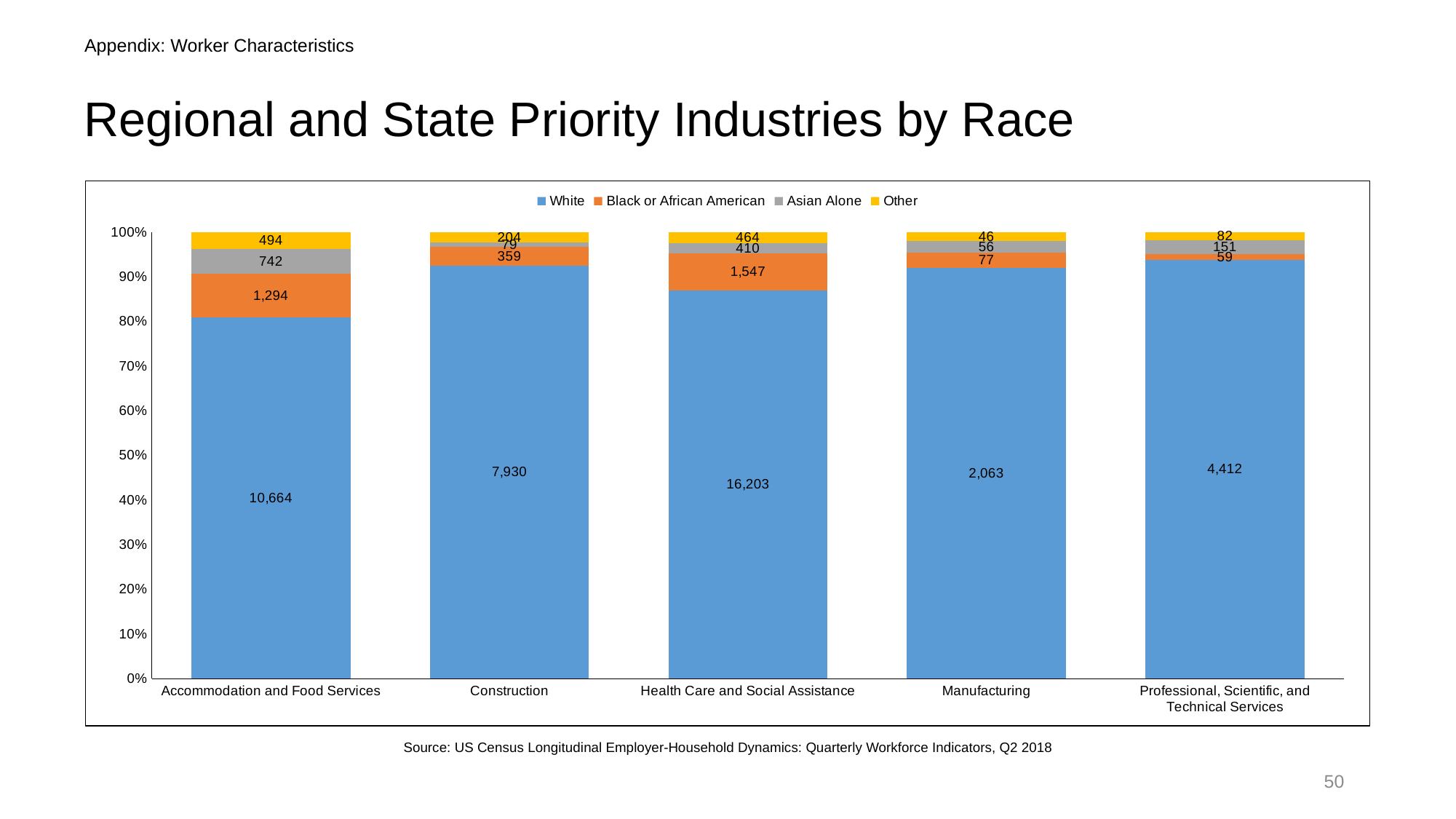
Which has the larger Asian Alone value, Accommodation and Food Services or Health Care and Social Assistance? Accommodation and Food Services What is the difference between the Black or African American values for Health Care and Social Assistance and Accommodation and Food Services? 253 How many industries are shown on the x axis? 5 Which industry has the lowest labelled value for White? Manufacturing What kind of chart is shown on the slide? Stacked bar chart What is the labelled value for White in Health Care and Social Assistance? 16,203 Is the White share of the Construction bar greater or less than 90%? greater Which industry has the highest labelled value for White? Health Care and Social Assistance What is the labelled value for Asian Alone in Professional, Scientific, and Technical Services? 151 What is the labelled value for Other in Construction? 204 What is the labelled value for Black or African American in Accommodation and Food Services? 1,294 How many series does the legend list? 4